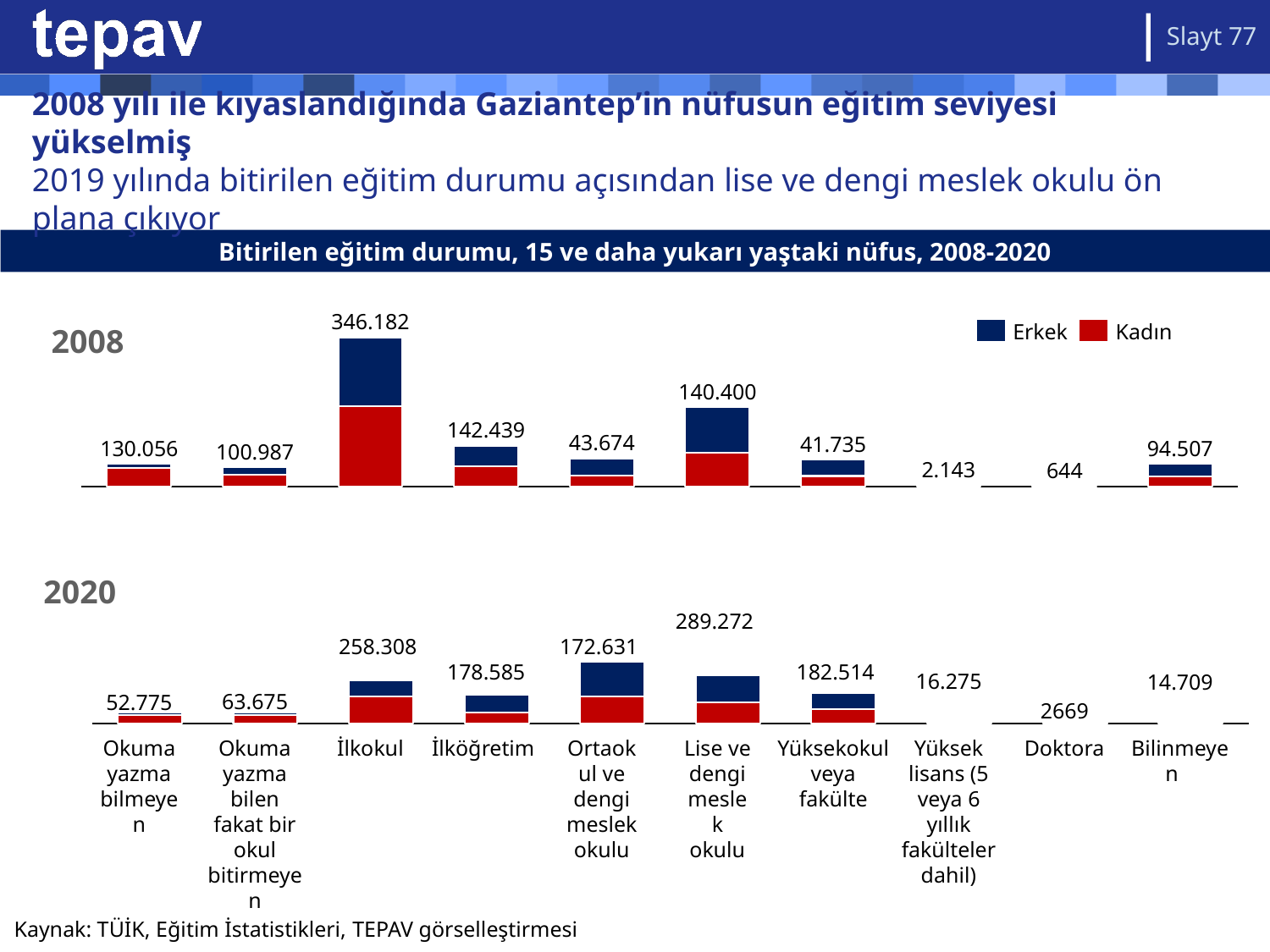
In the 2020 chart, what is the total value shown for Lise ve dengi meslek okulu? 289.272 How many education categories are shown along the x axis of the 2020 chart? 10 In the 2008 chart, what is the value shown for Doktora? 644 In the 2008 chart, what is the total value shown for İlkokul? 346.182 What is the difference between the İlkokul total in the 2008 chart and the İlkokul total in the 2020 chart? 87.874 How many series does the legend list? 2 In the 2008 chart, which category has the highest total? İlkokul In the 2020 chart, which category has the highest total? Lise ve dengi meslek okulu By how much did the Lise ve dengi meslek okulu total in the 2020 chart exceed the one in the 2008 chart? 148.872 In the 2020 chart, what is the value shown for Yüksekokul veya fakülte? 182.514 In the 2020 chart, which category has the lowest total? Doktora